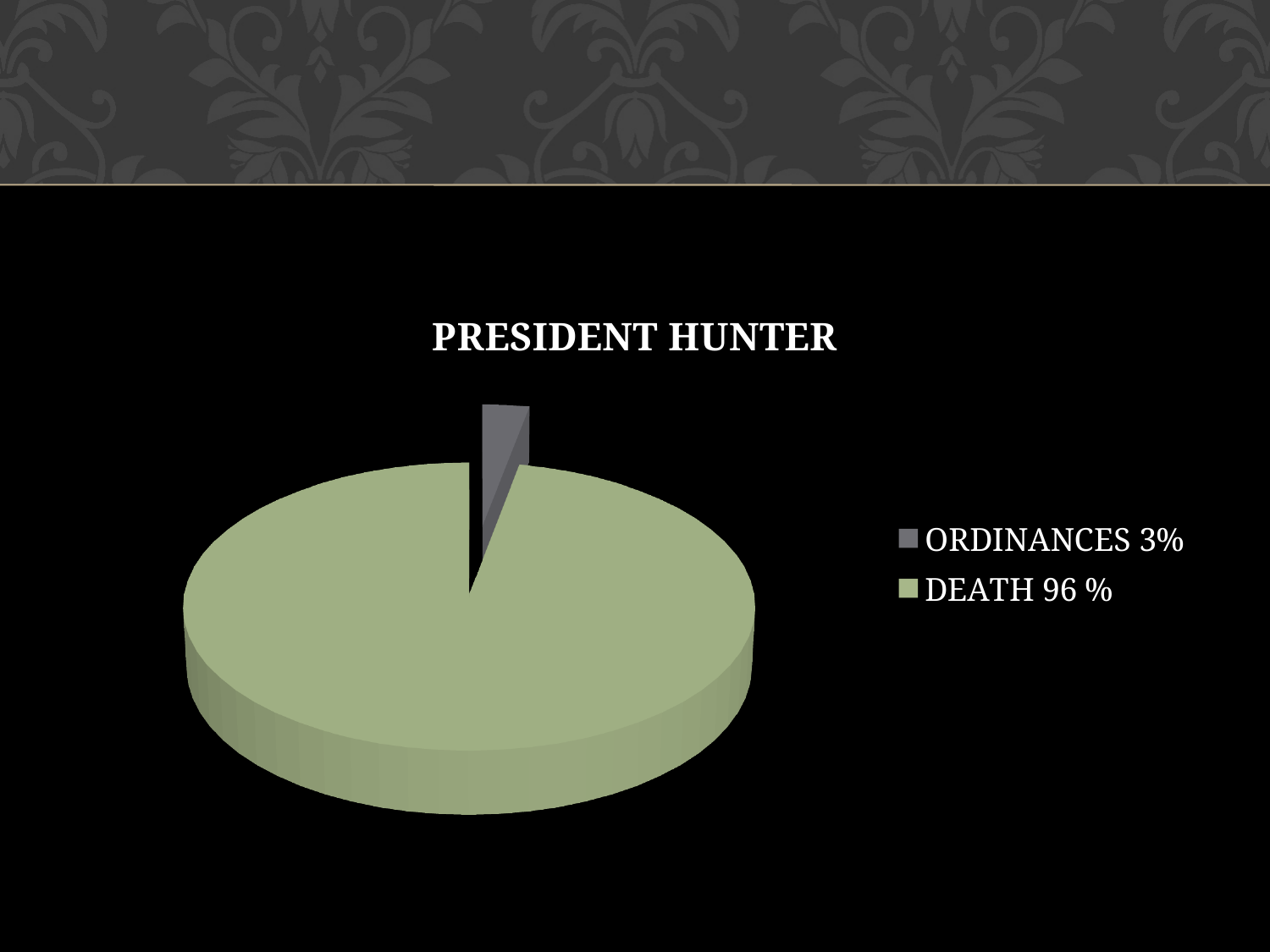
Which slice is larger, ORDINANCES or DEATH? DEATH What is the difference in percentage points between the DEATH and ORDINANCES slices? 93 How many entries does the legend list? 2 Is the share for DEATH greater or less than 50%? greater Which category has the smallest slice of the pie? ORDINANCES Which category has the largest slice of the pie? DEATH What colour is the DEATH slice in the pie chart? green What percentage is shown for DEATH in the legend? 96 % What percentage is shown for ORDINANCES in the legend? 3% What is the title of the chart? PRESIDENT HUNTER What kind of chart is shown on the slide? pie chart How many slices does the pie chart have? 2